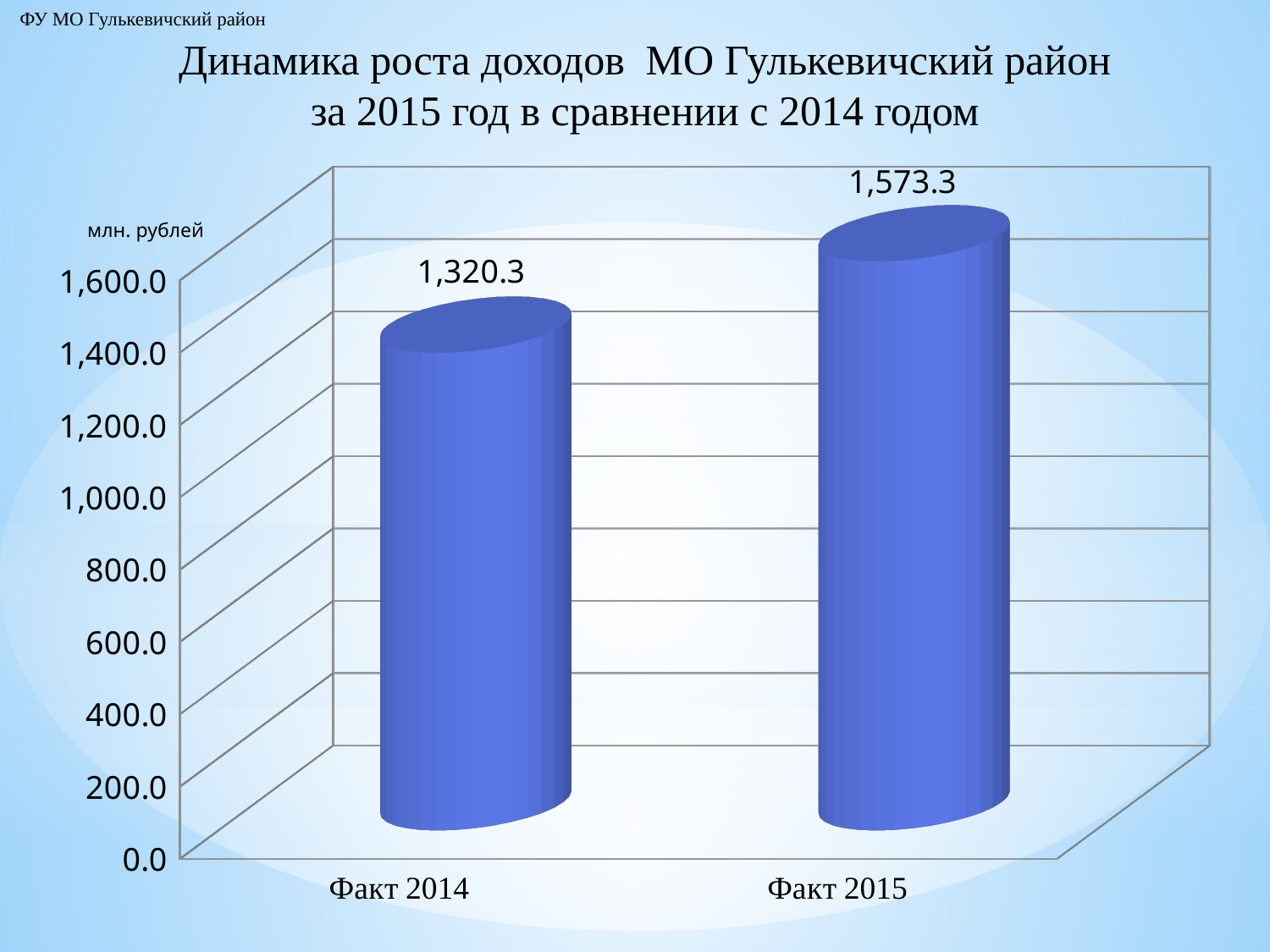
What is the value for Факт 2014? 1,320.3 Which category has the lowest value? Факт 2014 What is the value for Факт 2015? 1,573.3 What is the difference between the values for Факт 2015 and Факт 2014? 253.0 What unit is shown on the chart's value axis? млн. рублей Is the value for Факт 2015 greater or less than 1,400.0? greater What kind of chart is shown on the slide? bar chart Do the values rise or fall from Факт 2014 to Факт 2015? rise How many categories are shown on the x axis? 2 Which is larger, the value for Факт 2014 or Факт 2015? Факт 2015 Which category has the highest value? Факт 2015 Is the value for Факт 2014 greater or less than 1,400.0? less